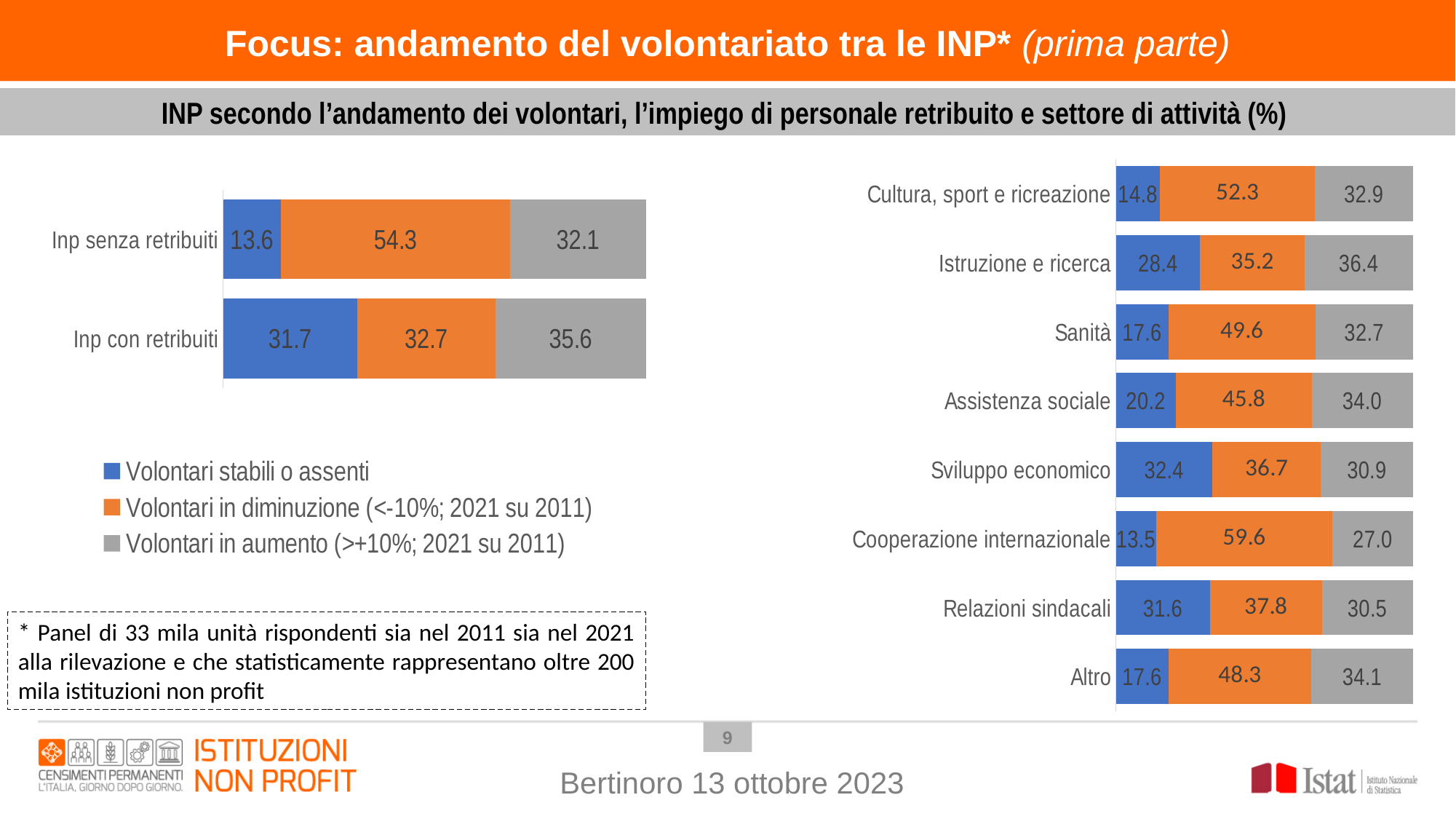
In the right chart, what is the value for 'Volontari in aumento' for 'Assistenza sociale'? 34.0 In the left chart, what is the value for 'Volontari stabili o assenti' for 'Inp con retribuiti'? 31.7 How many series does the legend list? 3 In the left chart, what is the difference in 'Volontari stabili o assenti' between 'Inp con retribuiti' and 'Inp senza retribuiti'? 18.1 In the right chart, which sector has the highest value for 'Volontari in aumento'? Istruzione e ricerca How many sectors are shown in the right chart? 8 What kind of chart is the right chart? Stacked bar chart In the right chart, which sector has the highest value for 'Volontari in diminuzione'? Cooperazione internazionale In the right chart, what is the value for 'Volontari in diminuzione' for 'Cooperazione internazionale'? 59.6 In the right chart, which is larger: 'Volontari stabili o assenti' for 'Istruzione e ricerca' or for 'Sanità'? Istruzione e ricerca In the right chart, which sector has the lowest value for 'Volontari in aumento'? Cooperazione internazionale In the left chart, what is the value for 'Volontari in diminuzione' for 'Inp senza retribuiti'? 54.3